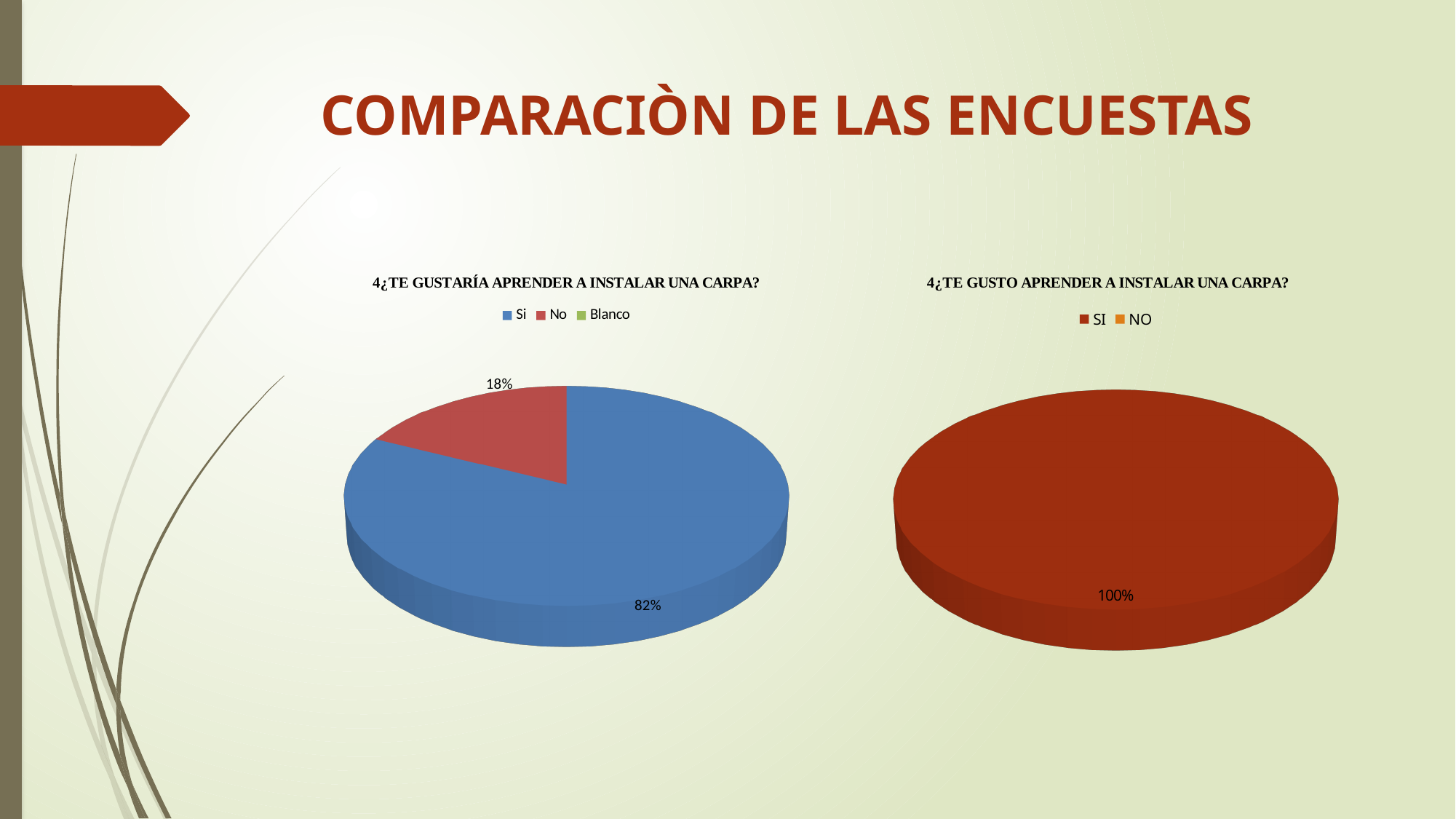
How many entries does the legend of the right chart titled '4¿TE GUSTO APRENDER A INSTALAR UNA CARPA?' list? 2 In the right chart titled '4¿TE GUSTO APRENDER A INSTALAR UNA CARPA?', what percentage is shown for 'SI'? 100% What kind of chart is the left chart titled '4¿TE GUSTARÍA APRENDER A INSTALAR UNA CARPA?'? Pie chart In the left chart titled '4¿TE GUSTARÍA APRENDER A INSTALAR UNA CARPA?', what percentage is shown for 'Si'? 82% What kind of chart is the right chart titled '4¿TE GUSTO APRENDER A INSTALAR UNA CARPA?'? Pie chart How many entries does the legend of the left chart titled '4¿TE GUSTARÍA APRENDER A INSTALAR UNA CARPA?' list? 3 What is the title of the right chart on the slide? 4¿TE GUSTO APRENDER A INSTALAR UNA CARPA? In the left chart titled '4¿TE GUSTARÍA APRENDER A INSTALAR UNA CARPA?', what colour is the 'Si' slice? Blue In the left chart titled '4¿TE GUSTARÍA APRENDER A INSTALAR UNA CARPA?', what is the difference in percentage points between 'Si' and 'No'? 64 In the left chart titled '4¿TE GUSTARÍA APRENDER A INSTALAR UNA CARPA?', what percentage is shown for 'No'? 18% In the left chart titled '4¿TE GUSTARÍA APRENDER A INSTALAR UNA CARPA?', which is larger, 'Si' or 'No'? Si In the left chart titled '4¿TE GUSTARÍA APRENDER A INSTALAR UNA CARPA?', which category has the largest slice? Si